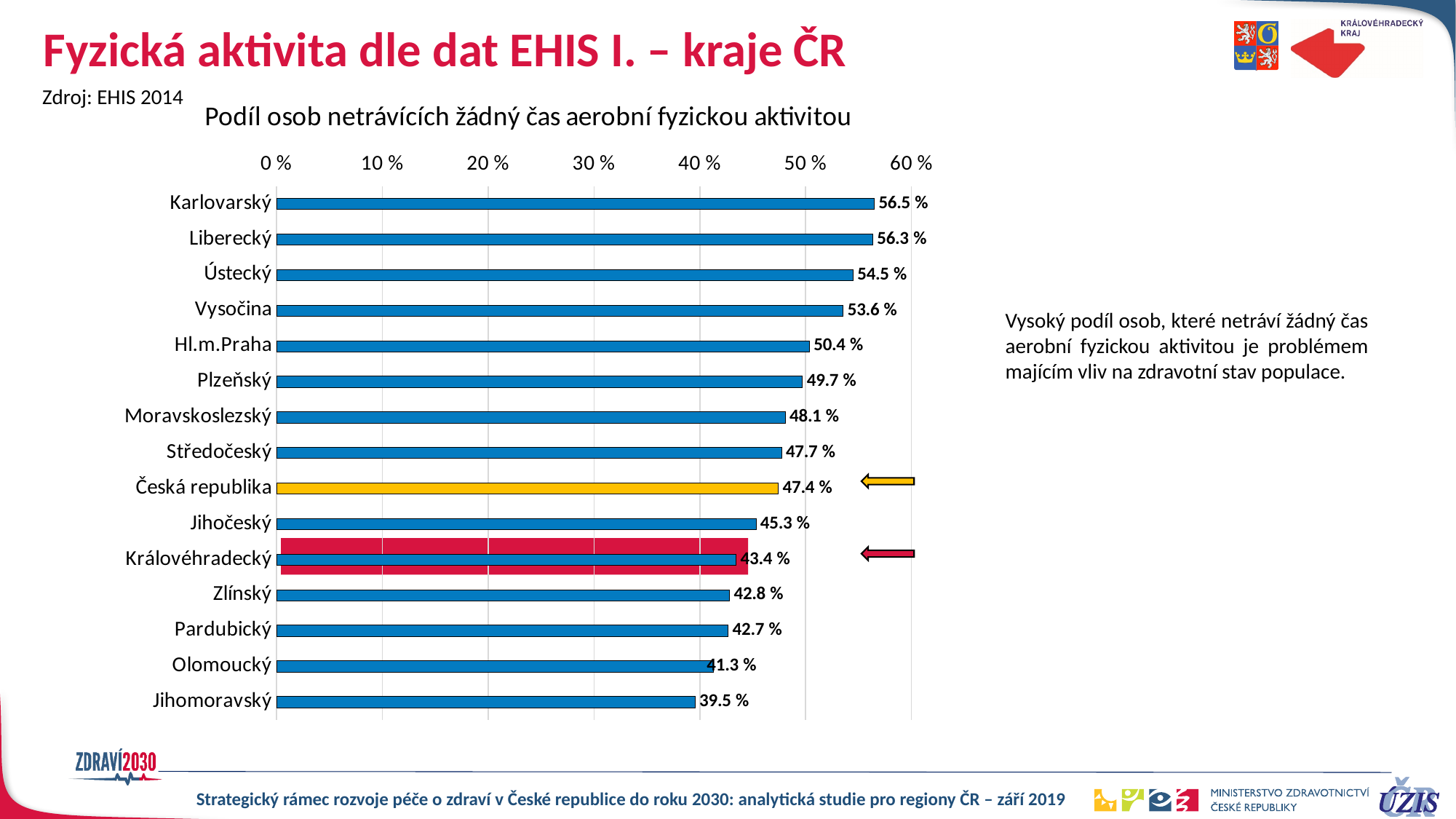
Is the value for Olomoucký greater or less than 40 %? greater Which category has the lowest value in the chart? Jihomoravský Which has a larger value, Ústecký or Vysočina? Ústecký What is the value for Hl.m.Praha? 50.4 % How many bars are plotted in the chart? 15 What is the difference between the values for Česká republika and Královéhradecký? 4.0 percentage points What is the value for Královéhradecký in the chart? 43.4 % What type of chart is shown on the slide? Bar chart Which category has the highest value in the chart? Karlovarský What is the difference between the values for Karlovarský and Jihomoravský? 17.0 percentage points What is the title of the chart? Podíl osob netrávících žádný čas aerobní fyzickou aktivitou What is the value shown for Česká republika? 47.4 %